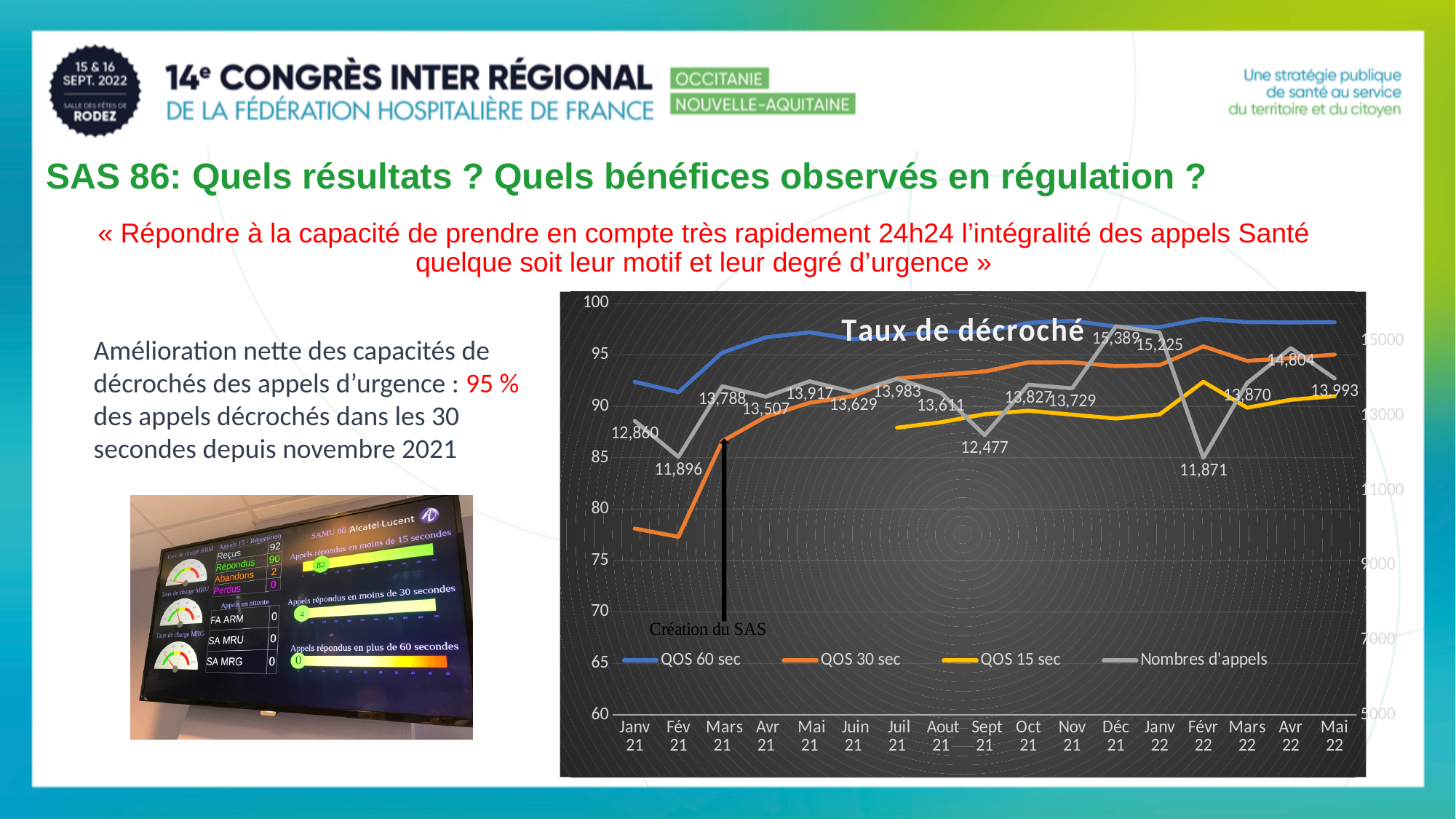
How many months are shown along the x axis of the chart? 17 Is the value of QOS 30 sec for Janv 21 greater or less than 80? less In which month is Nombres d'appels highest? Déc 21 What is the value of Nombres d'appels for Déc 21? 15,389 Which is larger, Nombres d'appels in Avr 22 or in Mai 22? Avr 22 What is the value of Nombres d'appels for Fév 22? 11,871 What is the difference between Nombres d'appels in Déc 21 and Janv 22? 164 What is the title of the chart? Taux de décroché How many series does the chart legend list? 4 What kind of chart is shown on the slide? line chart Does the QOS 30 sec series rise or fall from Janv 21 to Mai 22? rise Is the value of QOS 60 sec for Mai 22 greater or less than 95? greater